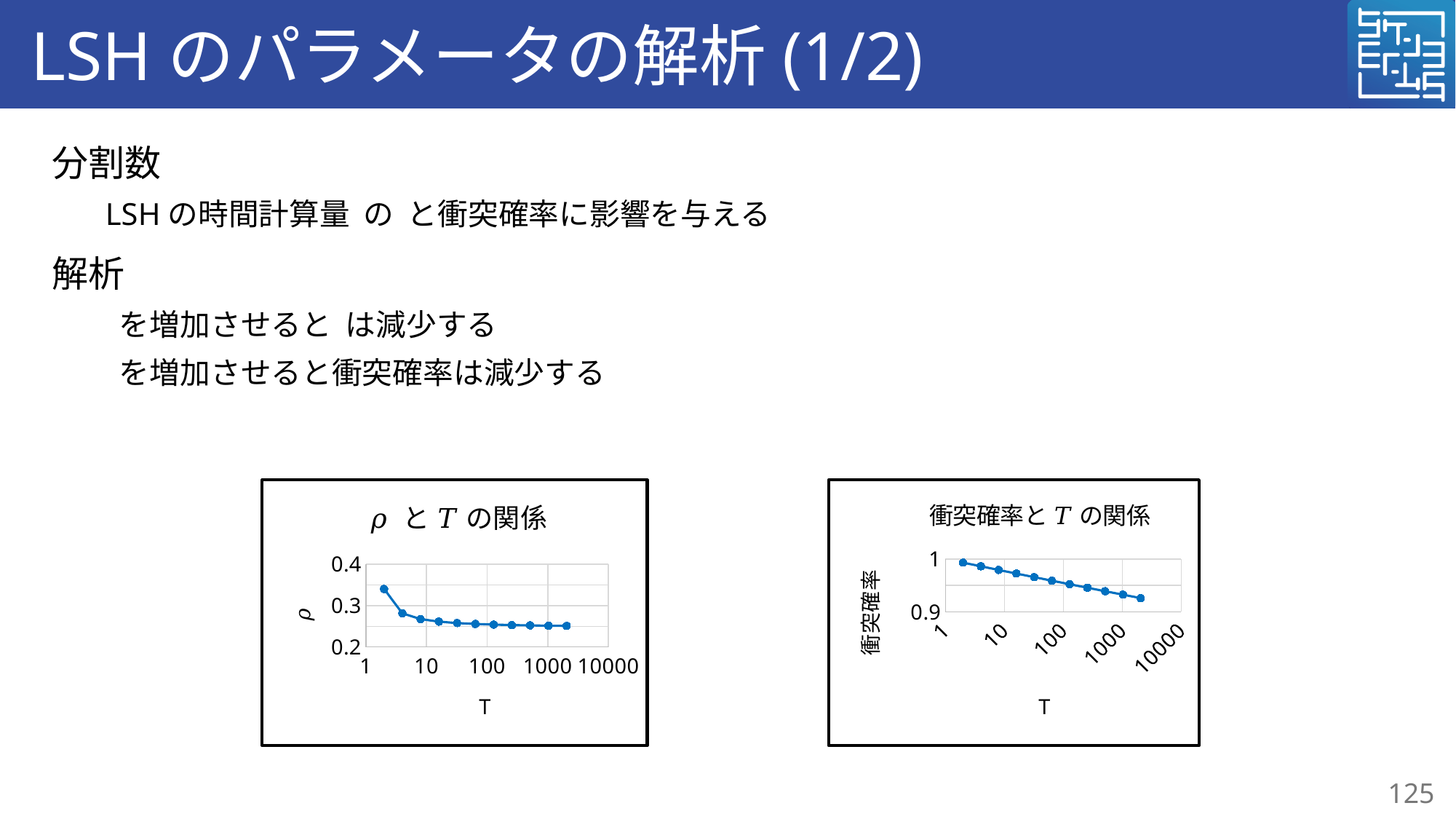
What kind of chart is the right chart titled '衝突確率と T の関係'? line chart What kind of chart is the left chart titled 'ρ と T の関係'? line chart What is the label of the x axis in the right chart '衝突確率と T の関係'? T In the left chart 'ρ と T の関係', is the value of ρ at the largest T greater or less than 0.3? less In the right chart '衝突確率と T の関係', does the collision probability rise or fall as T increases? fall How many data points are plotted in the left chart 'ρ と T の関係'? 11 In the left chart 'ρ と T の関係', do the values of ρ rise or fall as T increases? fall In the right chart '衝突確率と T の関係', is the collision probability at the smallest T greater or less than 0.95? greater In the left chart 'ρ と T の関係', is the value of ρ at the smallest T greater or less than 0.3? greater What is the label of the y axis in the left chart? ρ